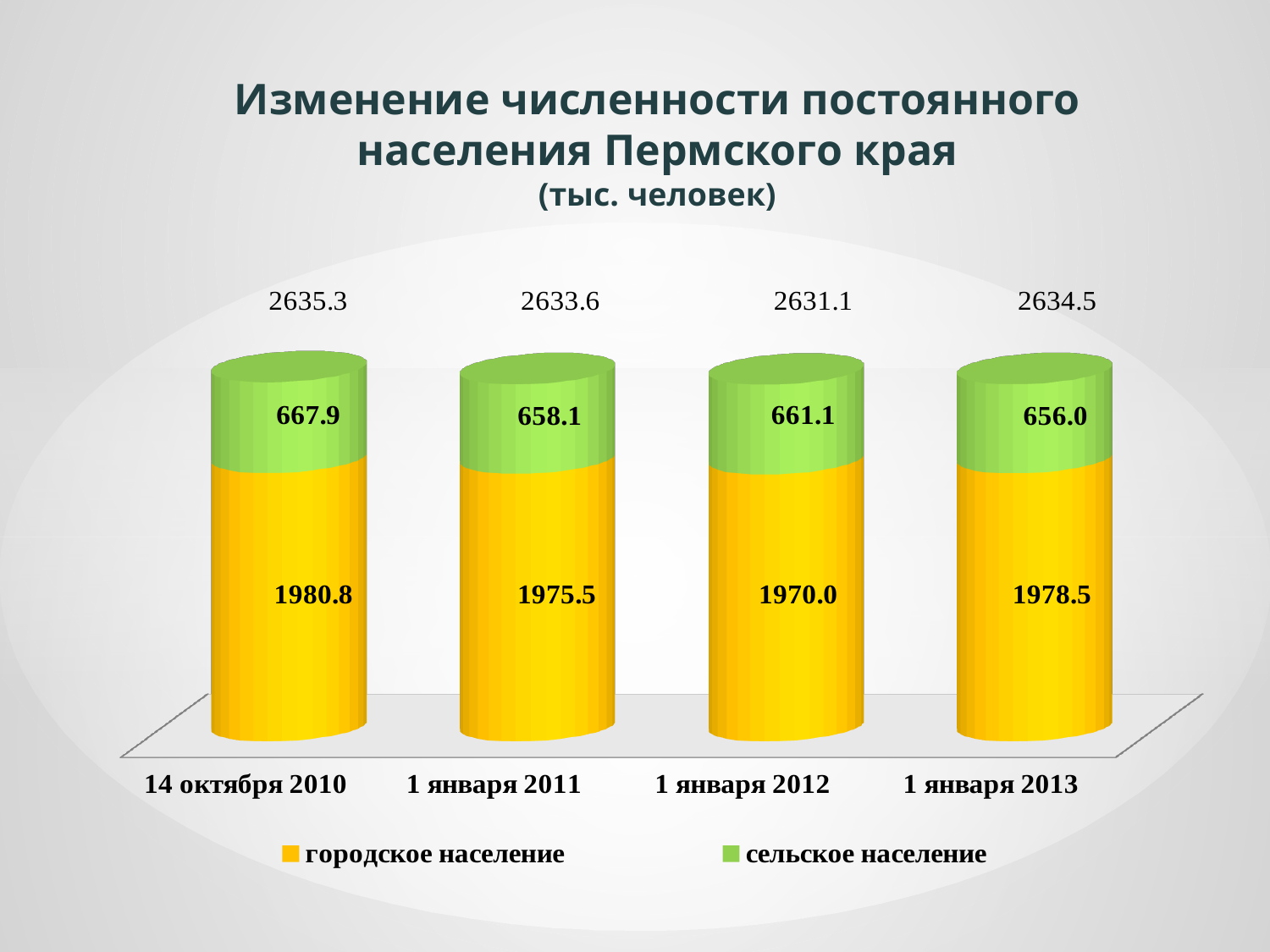
Which date has the highest value for городское население? 14 октября 2010 Which is larger: сельское население on 1 января 2011 or on 1 января 2012? 1 января 2012 What is the difference between городское население on 14 октября 2010 and on 1 января 2012? 10.8 What is the value for сельское население on 1 января 2013? 656.0 How many series does the legend list? 2 What is the total population shown above the bar for 1 января 2011? 2633.6 Which colour represents сельское население in the chart? Green What is the value for сельское население on 14 октября 2010? 667.9 Which date has the lowest value for сельское население? 1 января 2013 How many dates (categories) are shown on the x axis? 4 What is the value for городское население on 1 января 2012? 1970.0 What kind of chart is shown on the slide? Stacked bar chart